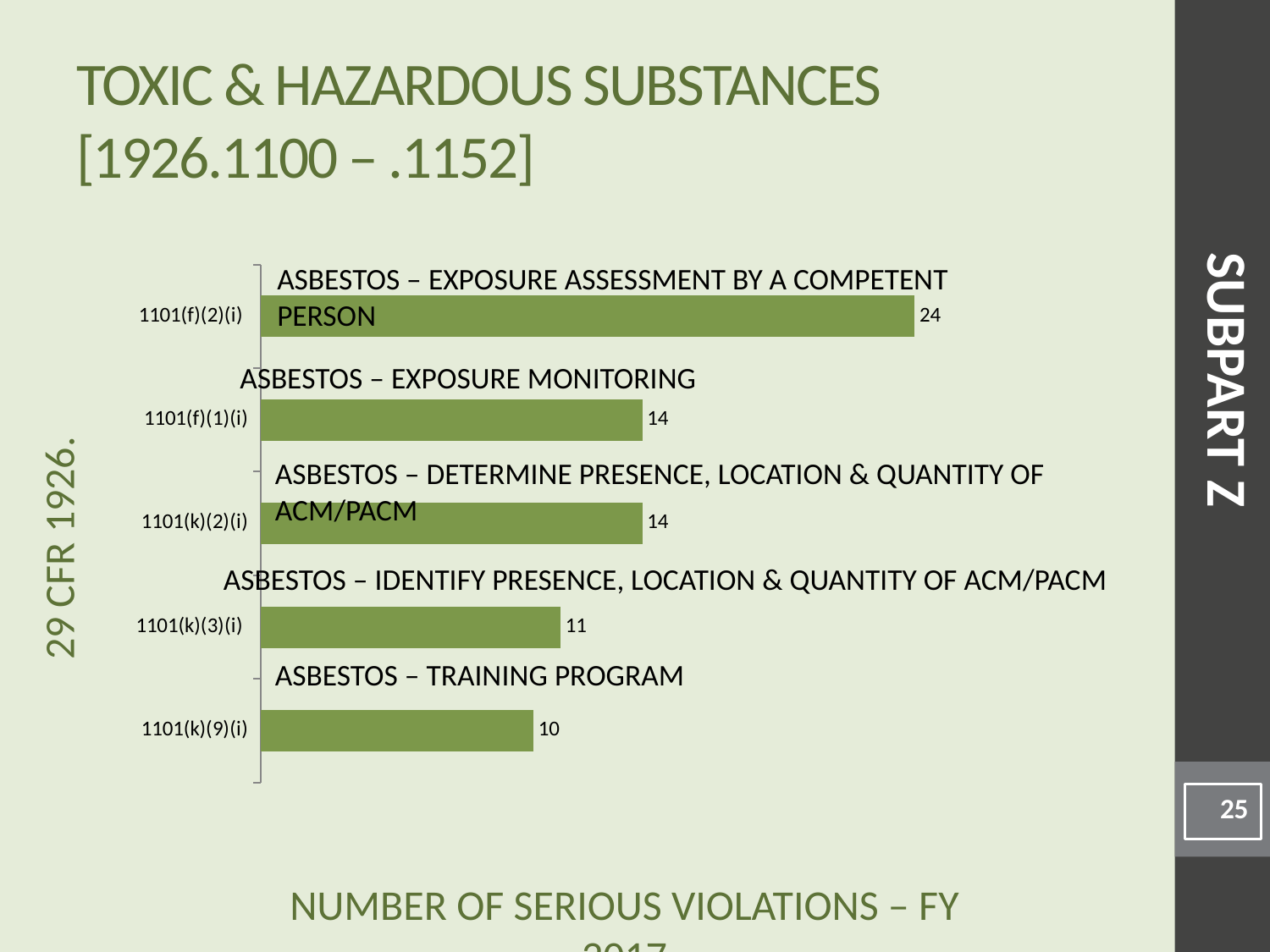
Which standard has the lowest number of serious violations? 1101(k)(9)(i) What is the number of serious violations for 1101(f)(2)(i)? 24 What type of chart is shown on the slide? Bar chart What is the number of serious violations for 1101(k)(3)(i)? 11 How many standards (bars) are shown in the chart? 5 What is the difference between the serious violations for 1101(k)(3)(i) and 1101(k)(9)(i)? 1 What is the number of serious violations for 1101(k)(9)(i)? 10 Which standard is labelled 'ASBESTOS – TRAINING PROGRAM'? 1101(k)(9)(i) What is the difference between the serious violations for 1101(f)(2)(i) and 1101(f)(1)(i)? 10 Which has more serious violations, 1101(k)(2)(i) or 1101(k)(3)(i)? 1101(k)(2)(i) Which standard has the highest number of serious violations? 1101(f)(2)(i) What is the number of serious violations for 1101(f)(1)(i)? 14